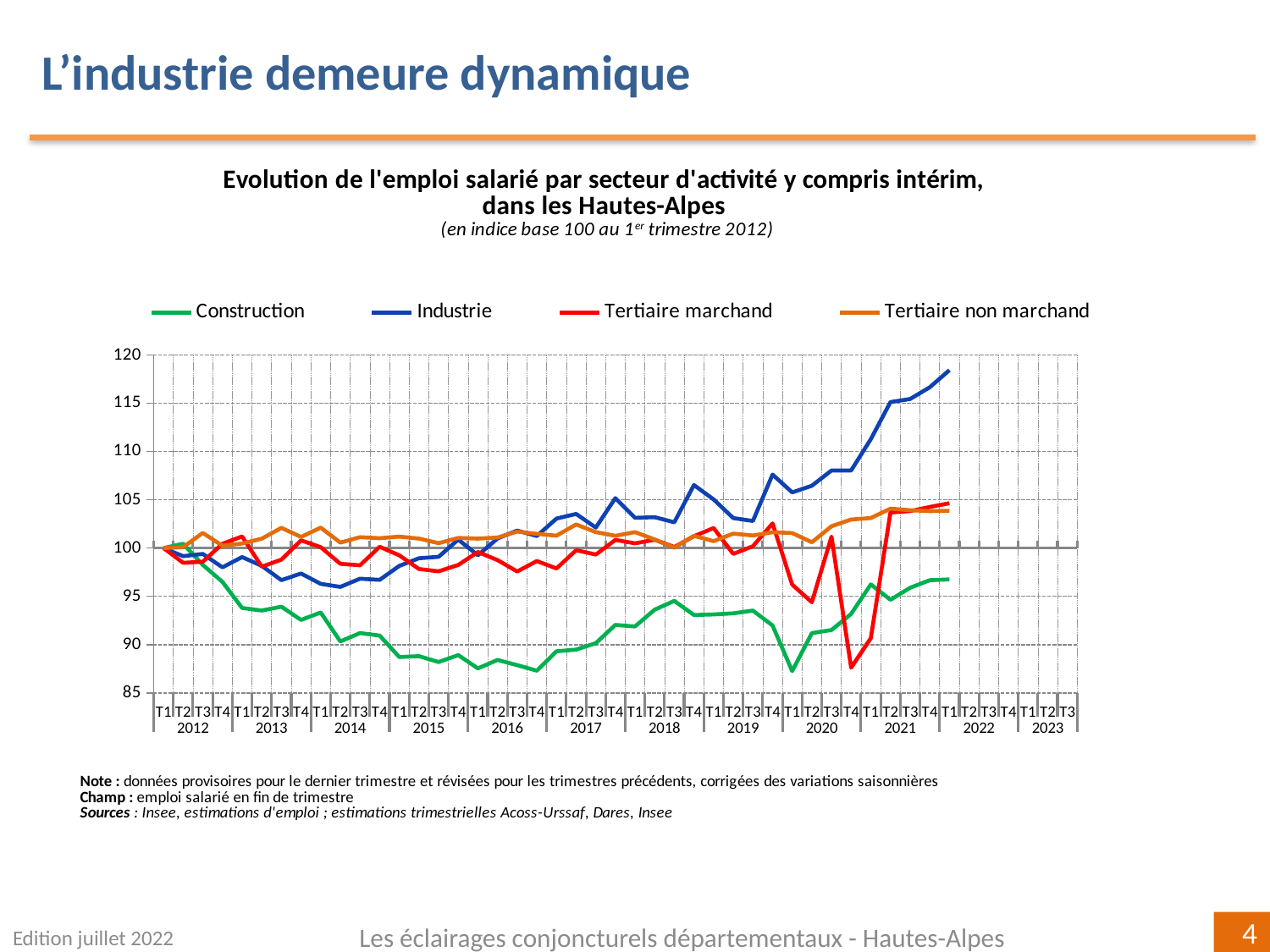
What kind of chart is shown on the slide? line chart At T1 2022, which is larger: Industrie or Tertiaire non marchand? Industrie Is the value for Tertiaire marchand at T4 2020 greater or less than 90? less Is the value for Construction at T1 2020 greater or less than 90? less Does the Construction series rise or fall from T1 2012 to T4 2016? falls What is the base period of the index used in the chart? 1er trimestre 2012 Is the value for Industrie at T1 2022 greater or less than 115? greater Does the Industrie series rise or fall overall from 2012 to 2022? rises How many series does the legend list? 4 Which series has the highest value at the last plotted point (T1 2022)? Industrie Which series has the lowest value at the last plotted point (T1 2022)? Construction